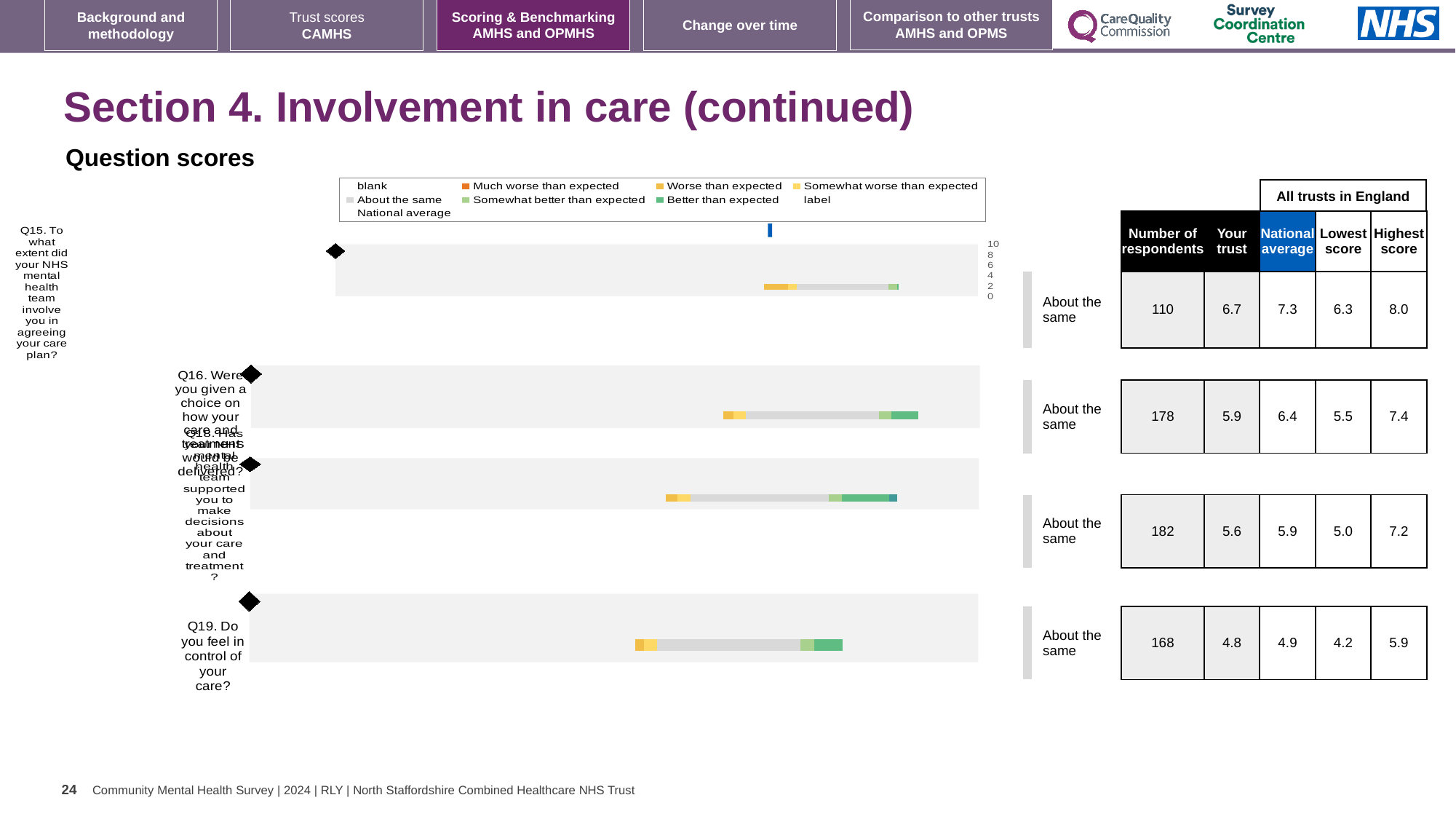
What is the national average score for Q16 (Were you given a choice on how your care and treatment would be delivered?)? 6.4 For Q19, how much higher is the national average than the 'Your trust' score? 0.1 For Q16, which is larger: the 'Your trust' score or the national average? National average What kind of chart is used to show the question scores? Bar chart What is the highest score across all trusts in England for Q18? 7.2 What is the 'Your trust' score for Q19 (Do you feel in control of your care?)? 4.8 Which question has the highest 'Your trust' score? Q15 How many questions are plotted in the chart? 4 For Q15, what is the difference between the highest score and the lowest score across all trusts in England? 1.7 Which question has the lowest 'Your trust' score? Q19 Which question had more respondents, Q15 or Q16? Q16 How many respondents answered Q18 (Has your NHS mental health team supported you to make decisions about your care and treatment?)? 182